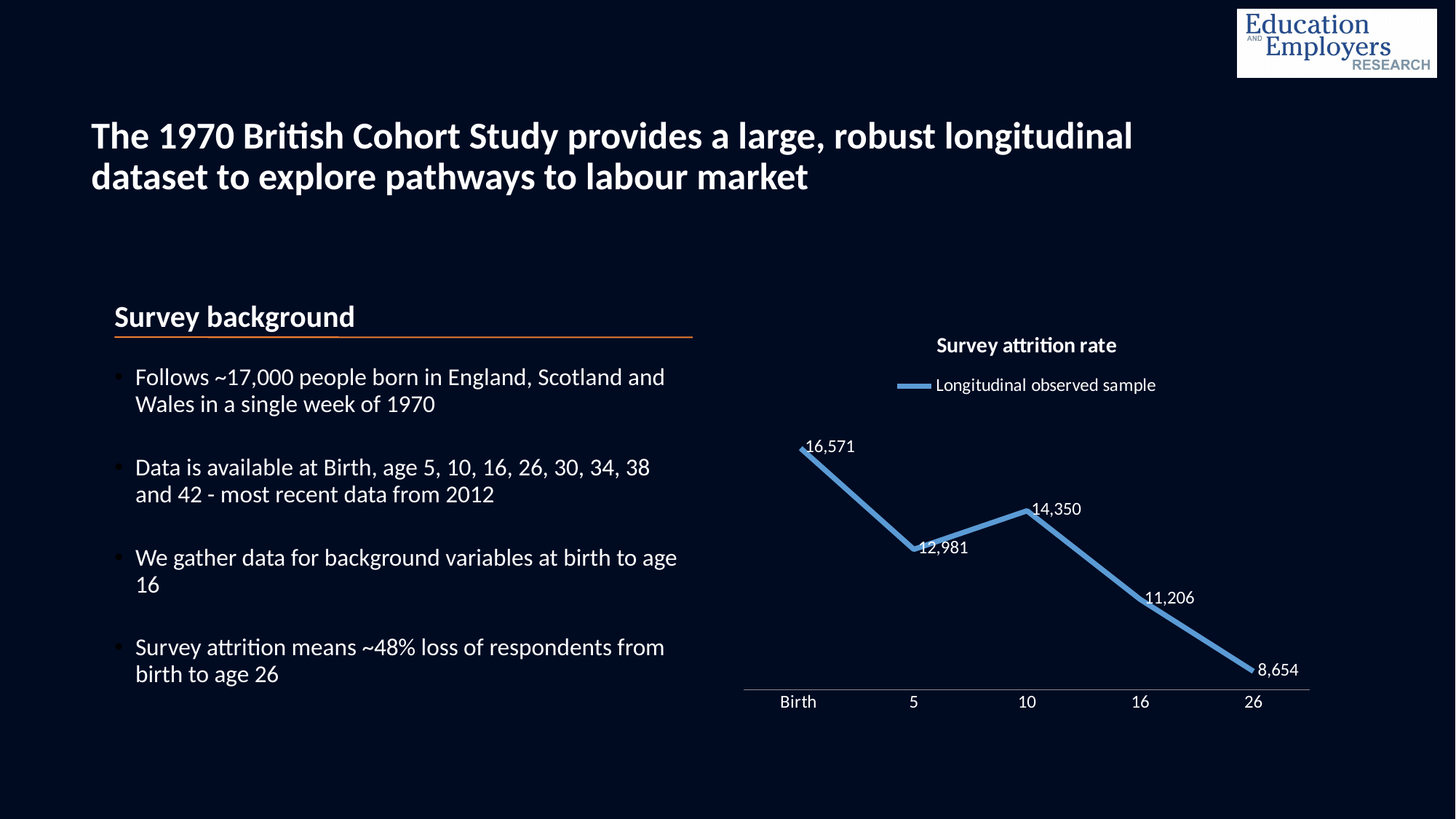
What is the difference between the sample at Birth and the sample at age 26? 7,917 Which is larger, the sample at age 5 or the sample at age 10? age 10 What is the longitudinal observed sample at age 16? 11,206 What is the title of the chart on the slide? Survey attrition rate What is the longitudinal observed sample at Birth? 16,571 What is the longitudinal observed sample at age 10? 14,350 What is the longitudinal observed sample at age 26? 8,654 What kind of chart is the Survey attrition rate chart? line chart At which point on the x axis is the longitudinal observed sample lowest? 26 How many data points are plotted on the Survey attrition rate chart? 5 At which point on the x axis is the longitudinal observed sample highest? Birth What is the longitudinal observed sample at age 5? 12,981